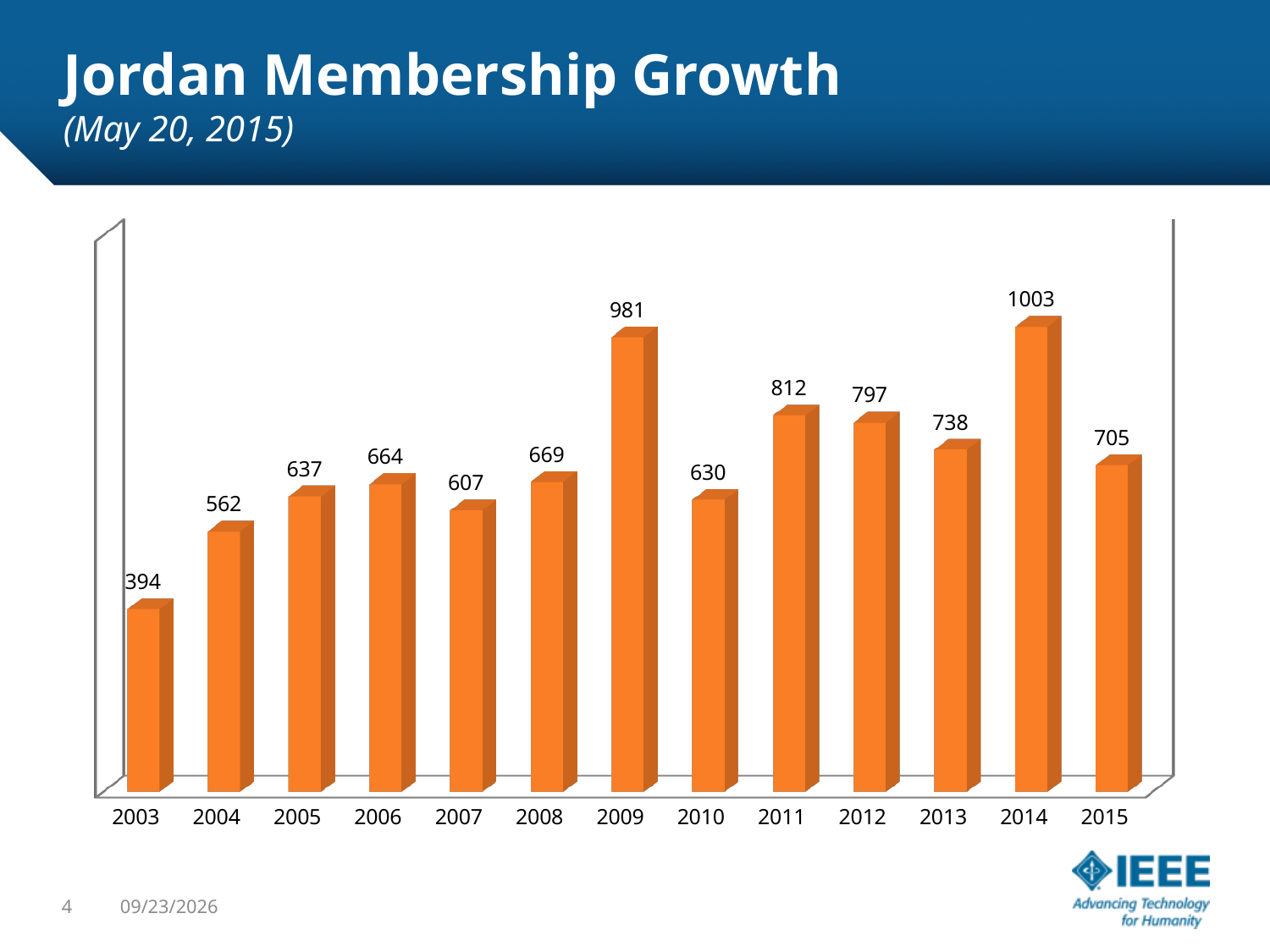
Which year has a larger membership value, 2005 or 2007? 2005 What is the membership value for 2015? 705 Which year has the lowest membership value? 2003 What kind of chart is shown on the slide? Bar chart What is the title of the chart on the slide? Jordan Membership Growth What is the membership value for 2009? 981 What is the difference between the membership values for 2009 and 2010? 351 How many years are shown on the x axis? 13 Which year has the highest membership value? 2014 Which year has a larger membership value, 2011 or 2012? 2011 What is the membership value for 2003? 394 What is the difference between the membership values for 2014 and 2013? 265